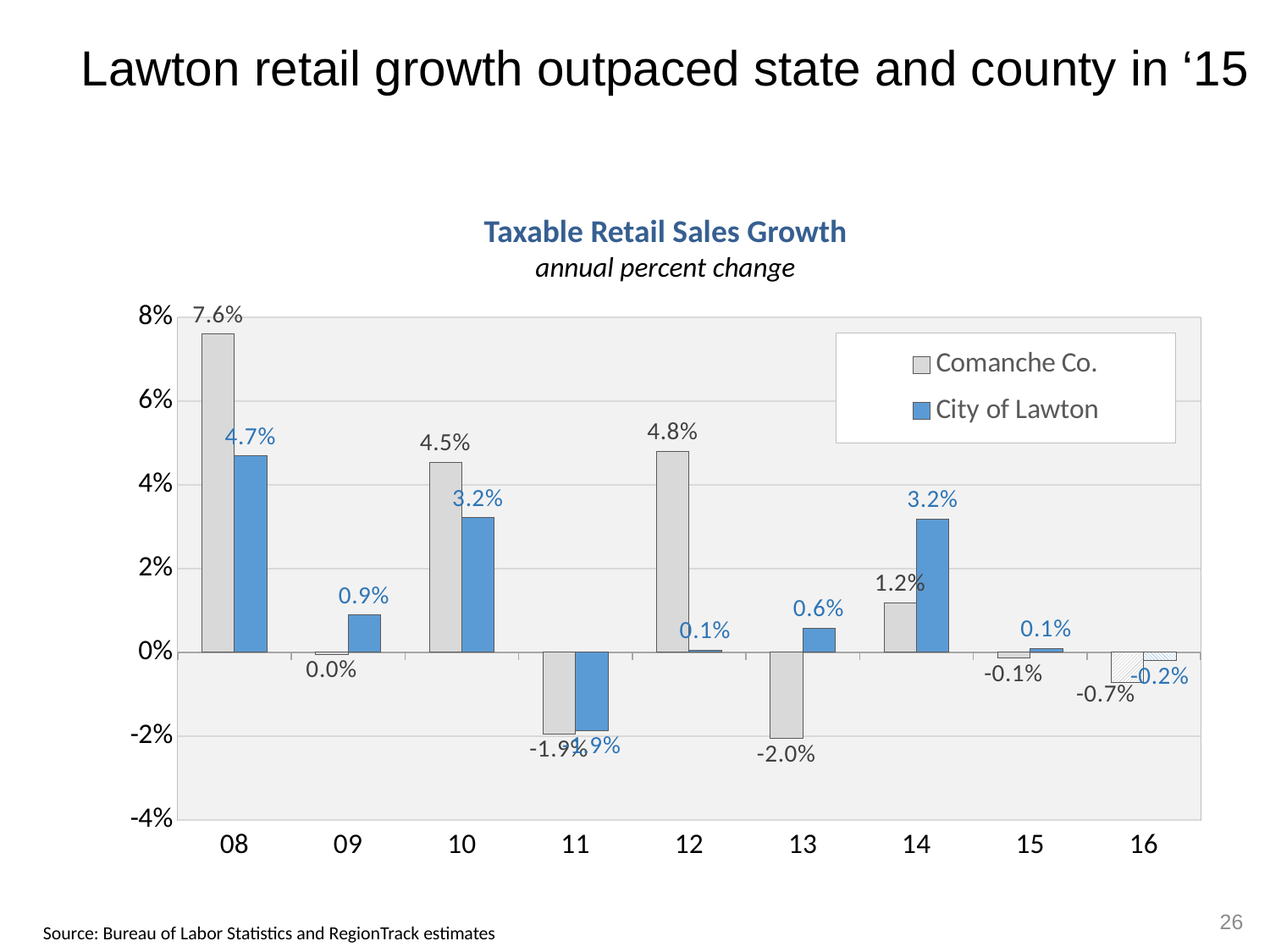
Which is larger for 14, the Comanche Co. value or the City of Lawton value? City of Lawton What is the City of Lawton value for 09? 0.9% In which year is the Comanche Co. value lowest? 13 What is the Comanche Co. value for 13? -2.0% What is the title of the chart? Taxable Retail Sales Growth What is the Comanche Co. value for 08? 7.6% What is the difference between the Comanche Co. and City of Lawton values for 12? 4.7% What kind of chart is shown? Bar chart How many series does the legend list? 2 In which year is the Comanche Co. value highest? 08 What is the City of Lawton value for 14? 3.2% How many years are shown on the x axis? 9